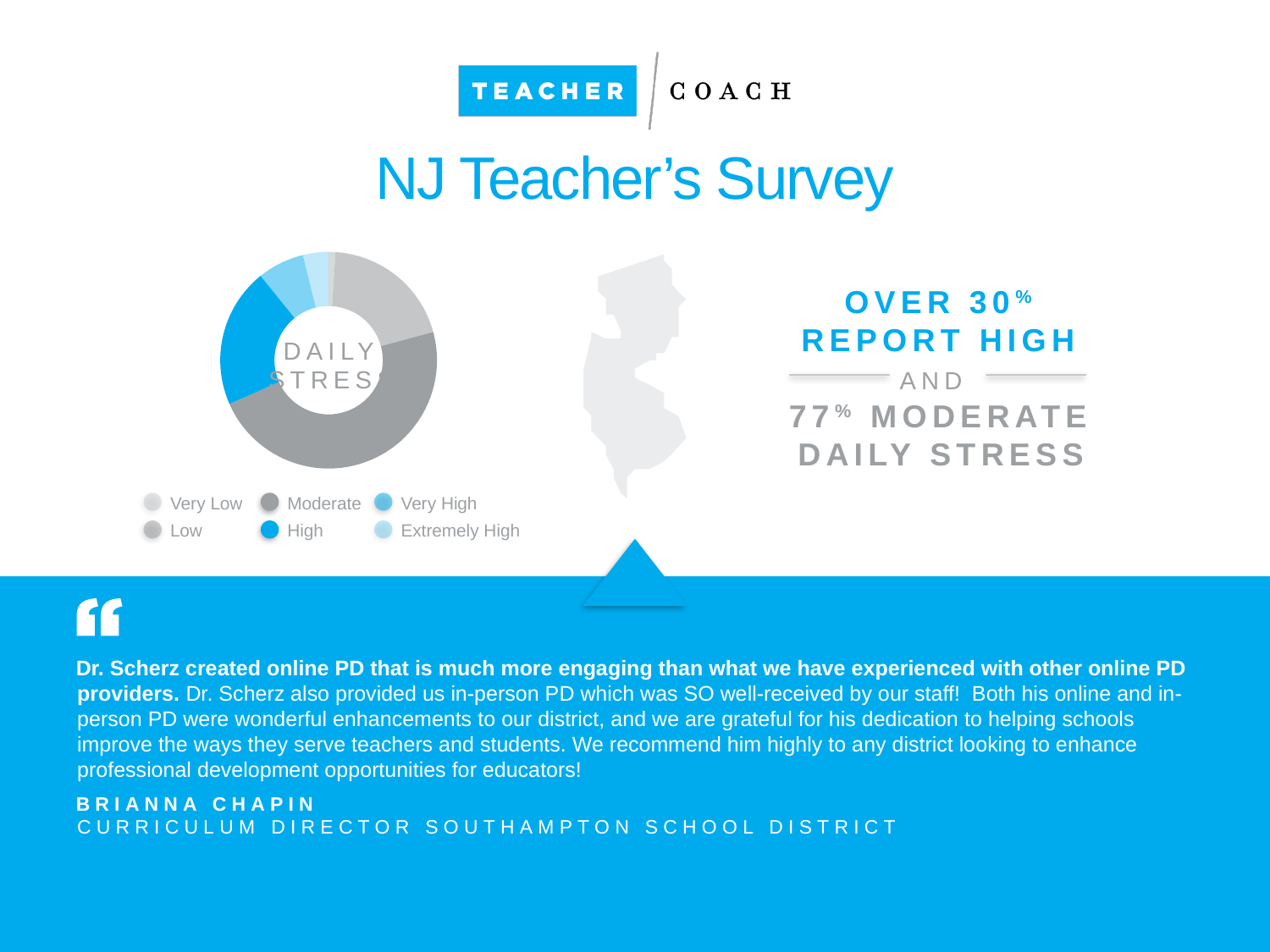
Which category has the smallest slice in the Daily Stress chart? Very Low What title appears in the centre of the donut chart? Daily Stress What colour is the High slice in the Daily Stress chart? Blue How many categories does the legend of the Daily Stress chart list? 6 In the Daily Stress chart, which slice is larger, Very High or Extremely High? Very High Which category has the largest slice in the Daily Stress chart? Moderate In the Daily Stress chart, which slice is larger, Moderate or High? Moderate In the Daily Stress chart, which slice is larger, High or Very High? High What kind of chart is shown on the slide? Pie chart (donut)